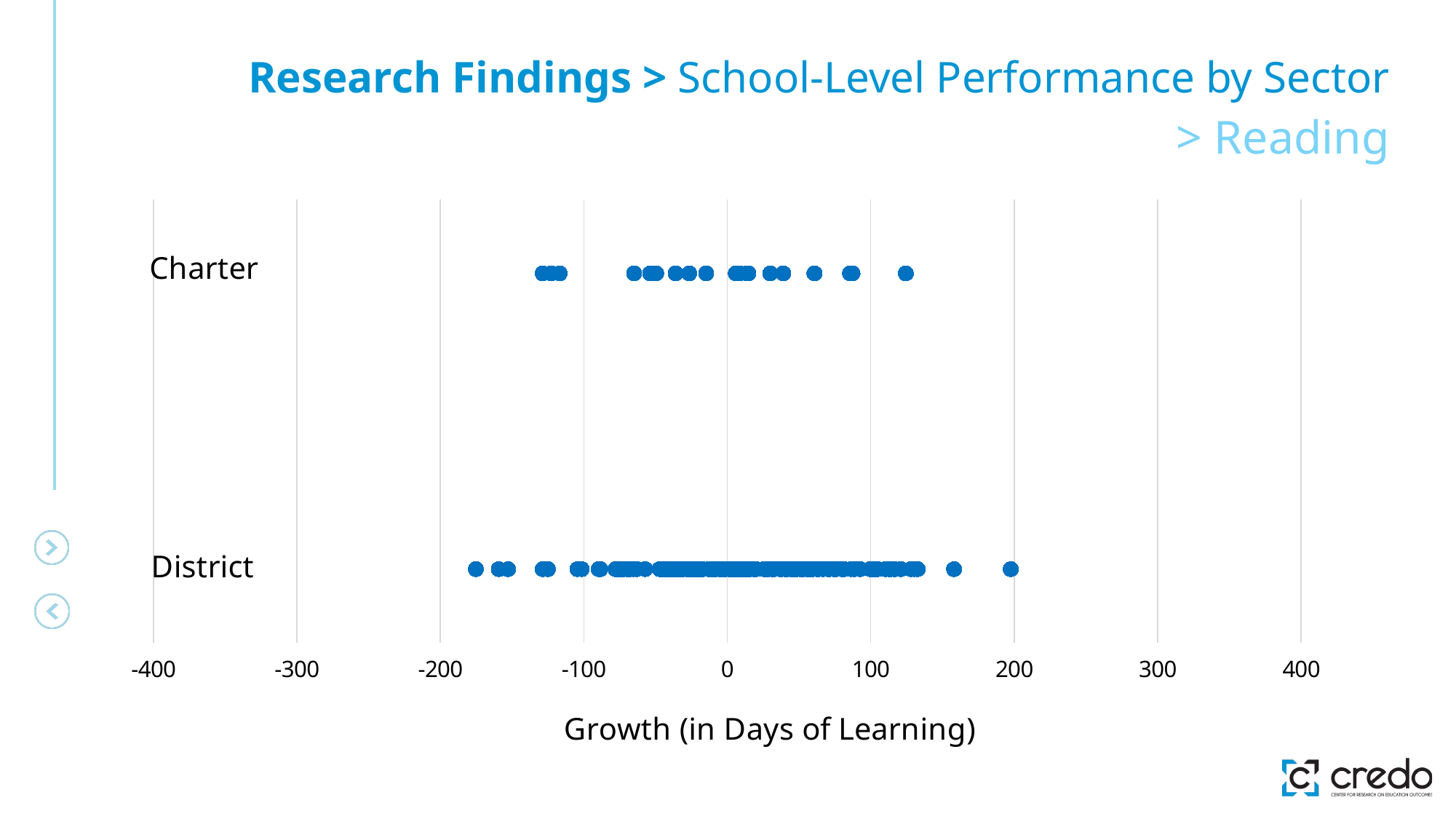
What is the title of the x axis? Growth (in Days of Learning) How many sector categories are plotted on the chart? 2 What subject does the chart cover, according to the slide title? Reading Which category shows the wider spread of growth values, Charter or District? District Which category has more schools (dots) plotted, Charter or District? District Is the highest Charter value greater or less than 200? less Is the lowest Charter value greater or less than -200? greater Is the highest Charter value greater or less than 100? greater Which category has the single lowest growth value plotted? District Which category has the single highest growth value plotted? District What kind of chart is shown on the slide? Scatter (dot) plot